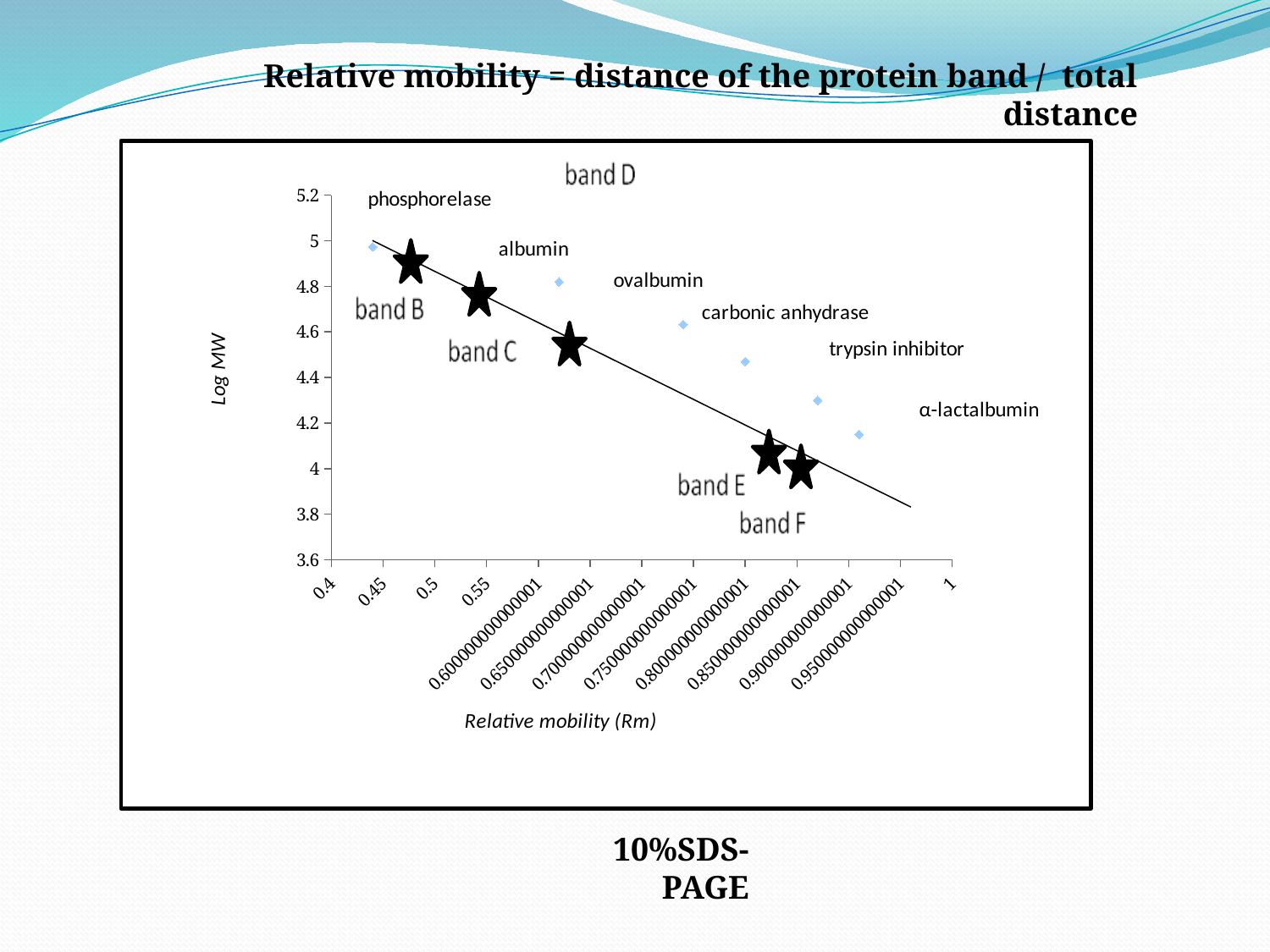
Is the Log MW value for ovalbumin greater or less than 4.4? greater Is the Log MW value for α-lactalbumin greater or less than 4.4? less What is the title of the y axis of the chart? Log MW Do the Log MW values rise or fall as relative mobility increases along the x axis? fall Which protein has the lowest Log MW value on the chart? α-lactalbumin What is the title of the x axis of the chart? Relative mobility (Rm) Which has a lower Log MW value, trypsin inhibitor or ovalbumin? trypsin inhibitor Is the Log MW value for phosphorelase greater or less than 4.8? greater Which protein has the highest Log MW value on the chart? phosphorelase Which has a higher Log MW value, albumin or carbonic anhydrase? albumin What kind of chart is shown on the slide? scatter chart How many labelled protein data points are plotted on the chart? 6